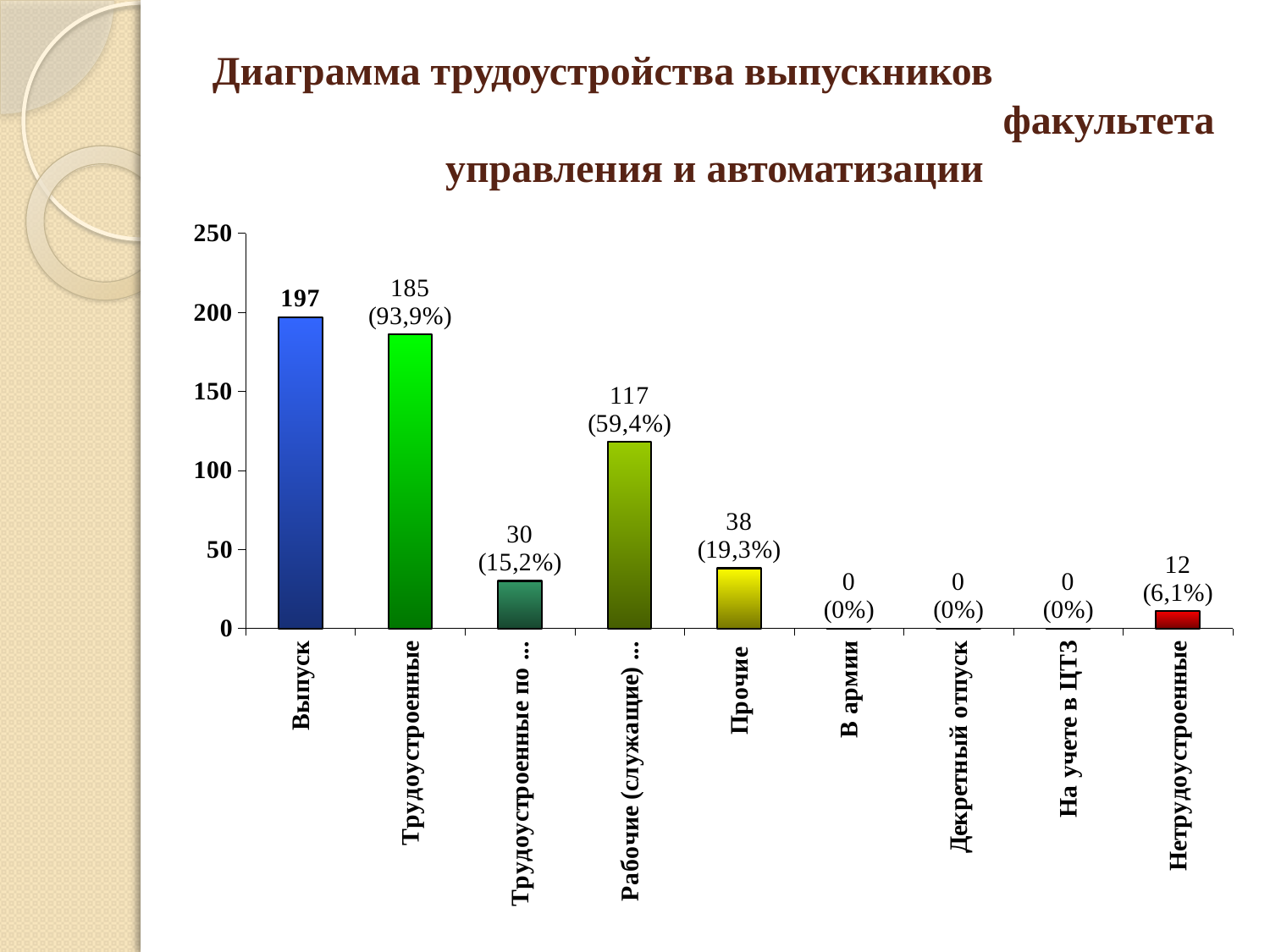
How many categories are shown on the x axis? 9 Which is larger, the value for Прочие or the value for Нетрудоустроенные? Прочие What percentage is shown for Прочие? 19,3% What is the value for Декретный отпуск? 0 Which category has the highest value? Выпуск What is the difference between the values for Выпуск and Трудоустроенные? 12 What is the value for Нетрудоустроенные? 12 What type of chart is shown on the slide? bar chart What percentage is shown for Трудоустроенные? 93,9% What is the value for Выпуск? 197 What is the value for Трудоустроенные? 185 Is the value for Прочие greater or less than 50? less